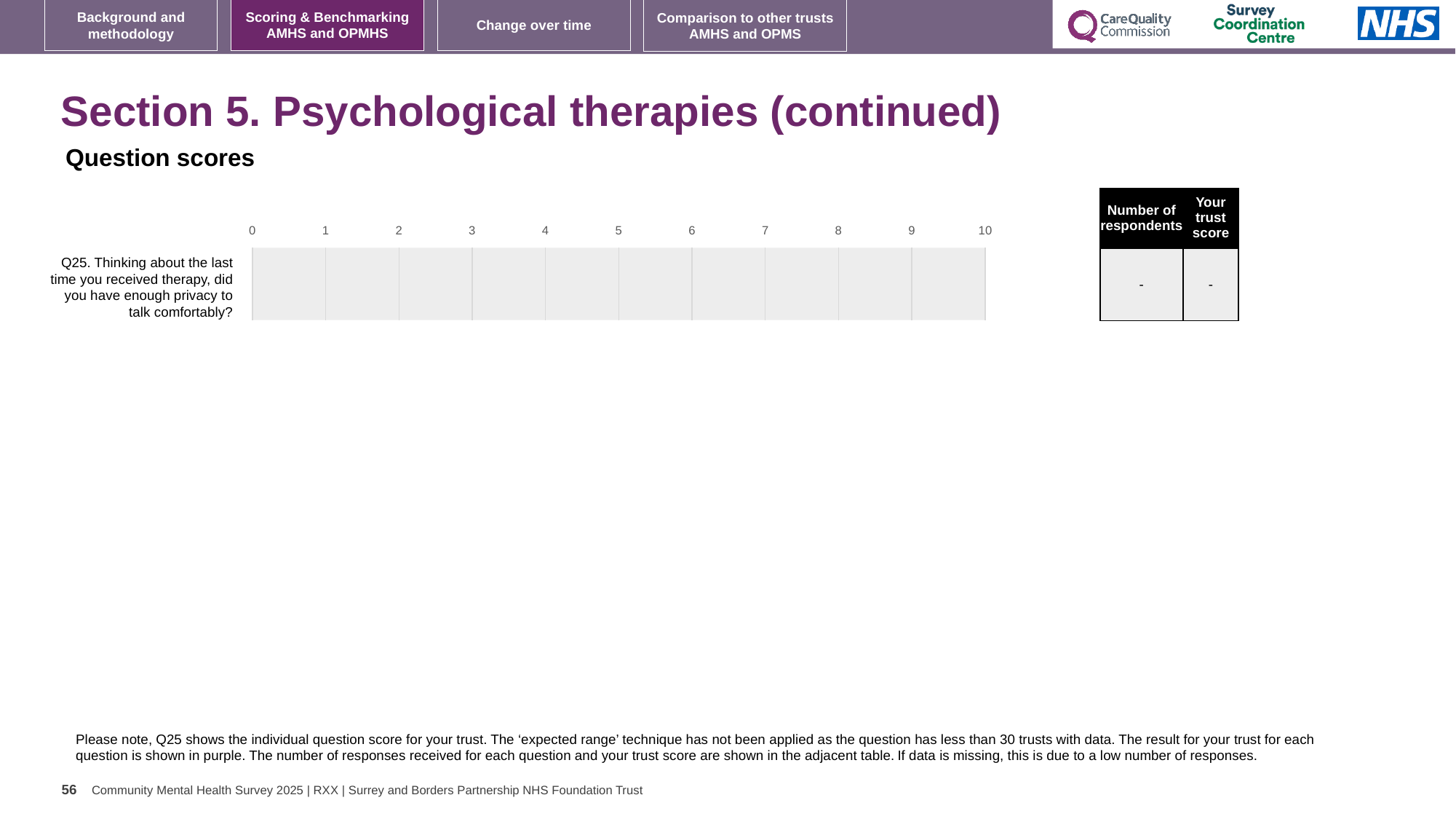
How many questions (categories) are plotted on the chart? 1 What value is shown in the 'Your trust score' column for Q25? - What value is shown in the 'Number of respondents' column for Q25? - Is a bar plotted for Q25 on the chart? No What is the lowest value shown on the chart's horizontal axis? 0 What is the highest value shown on the chart's horizontal axis? 10 Which question is listed as the category on the chart? Q25. Thinking about the last time you received therapy, did you have enough privacy to talk comfortably?